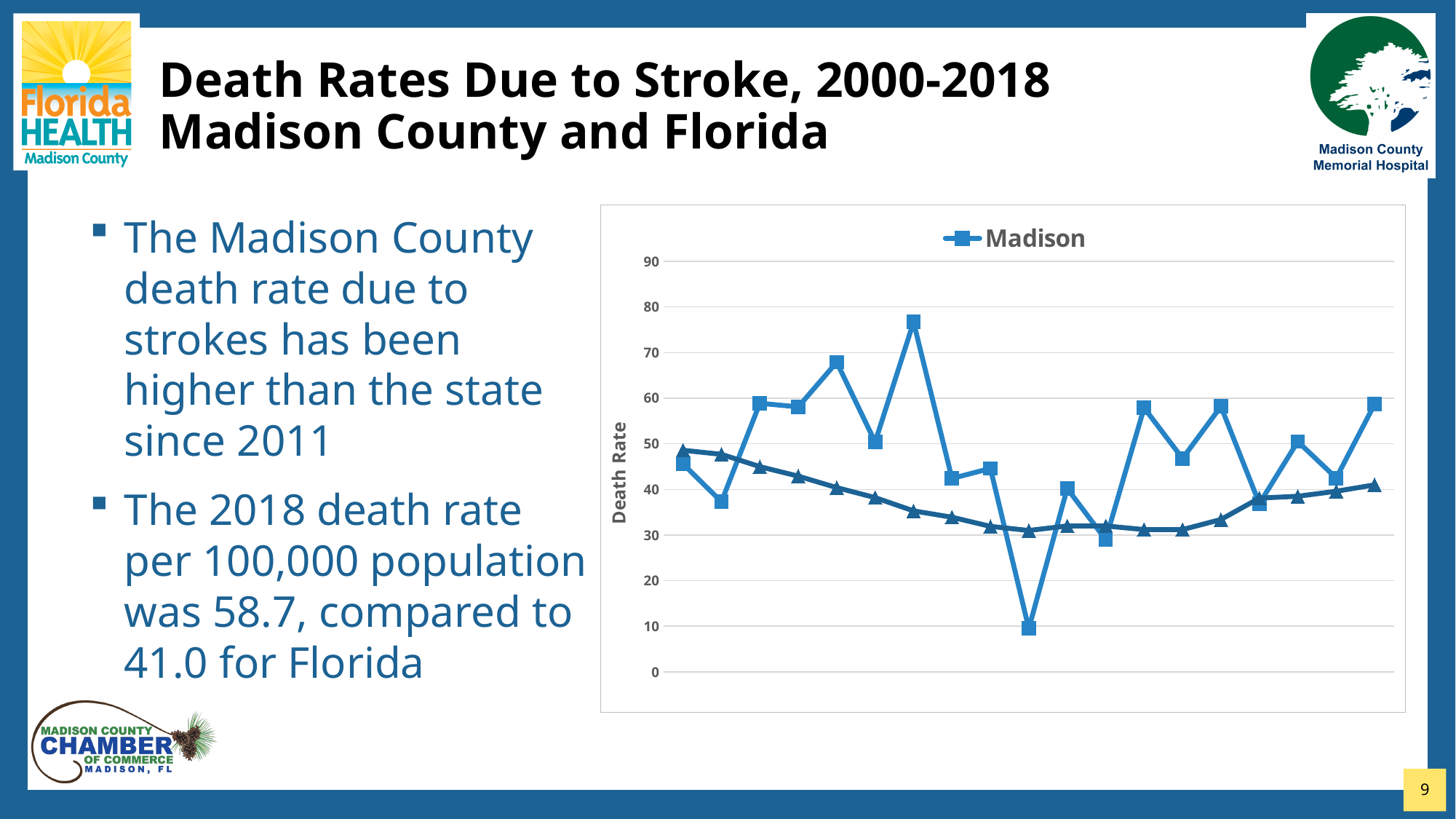
What is the highest tick value shown on the vertical axis? 90 Is the lowest value of the Madison series greater or less than 20? less Is the last (rightmost) value of the Madison series greater or less than 50? greater Is the first (leftmost) value of the Madison series greater or less than 50? less How many data points are plotted for the Madison series? 19 What kind of chart is shown on the slide? line chart Which is larger for the Madison series: the first point or the last point? the last point How many series does the chart legend list? 1 What is the title of the vertical axis? Death Rate